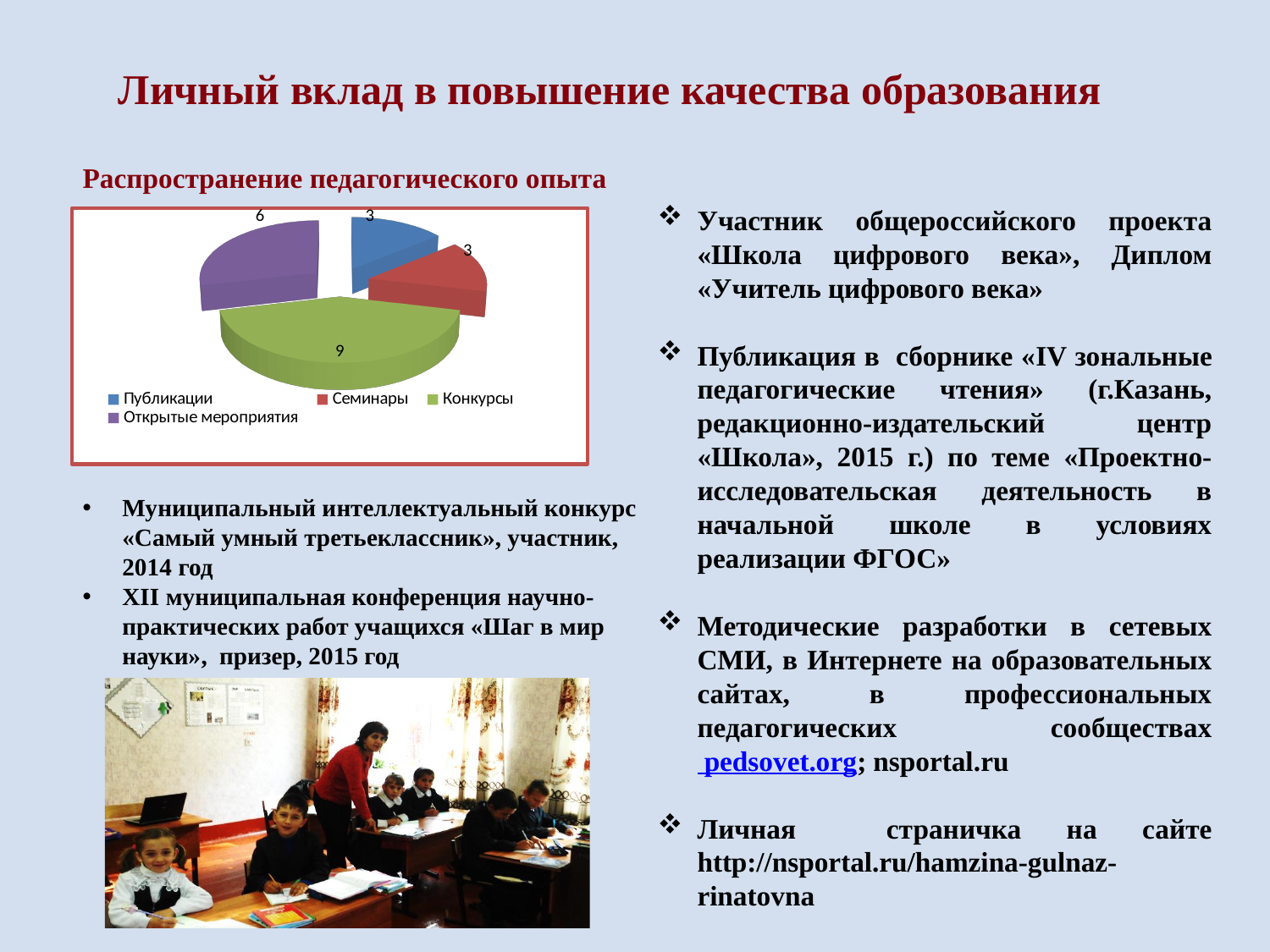
How many categories does the pie chart show? 4 What is the value for Публикации in the pie chart? 3 What kind of chart is shown on the slide? pie chart What is the difference between the values for Конкурсы and Открытые мероприятия? 3 Which is larger, the value for Открытые мероприятия or the value for Публикации? Открытые мероприятия What is the value for Конкурсы in the pie chart? 9 Which category has the largest slice in the pie chart? Конкурсы What colour is the Конкурсы slice in the pie chart? green How many entries does the legend of the pie chart list? 4 What is the value for Открытые мероприятия in the pie chart? 6 What is the total of all slices in the pie chart? 21 What is the value for Семинары in the pie chart? 3